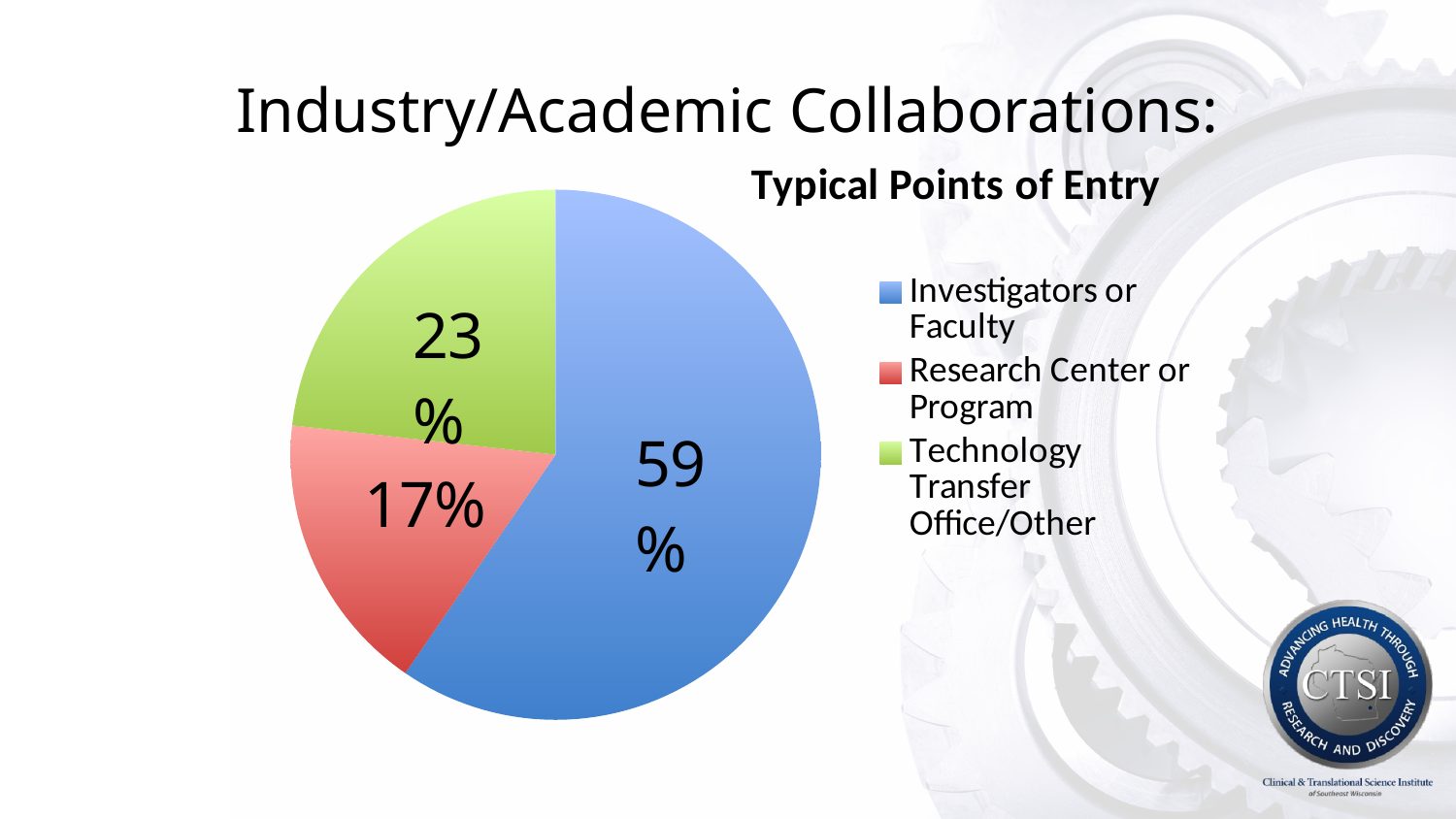
What colour is the Investigators or Faculty slice? blue What share of the pie is Investigators or Faculty? 59% What share of the pie is Technology Transfer Office/Other? 23% How many entries does the legend list? 3 How many slices does the pie chart have? 3 Which category has the largest slice of the pie? Investigators or Faculty What share of the pie is Research Center or Program? 17% Which is larger, the Technology Transfer Office/Other slice or the Research Center or Program slice? Technology Transfer Office/Other Which category has the smallest slice of the pie? Research Center or Program What kind of chart is shown on the slide? pie chart What is the difference in percentage points between Investigators or Faculty and Technology Transfer Office/Other? 36 What is the chart's title? Typical Points of Entry